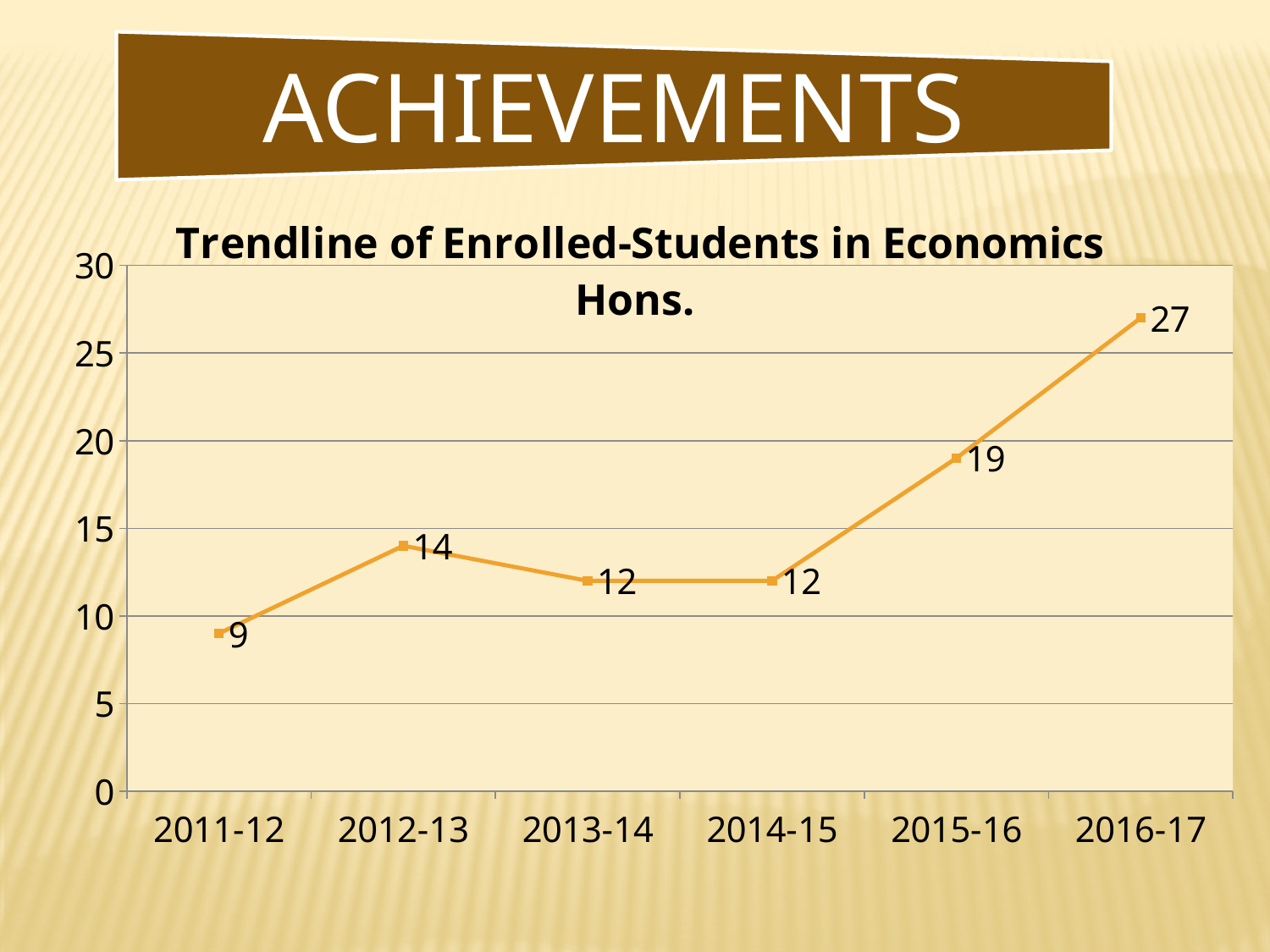
What is the value for 2011-12? 9 What kind of chart is this? line chart What is the difference between the values for 2016-17 and 2015-16? 8 Which year has the lowest value? 2011-12 Which is larger, the value for 2012-13 or the value for 2013-14? 2012-13 What is the value for 2015-16? 19 Do the values rise or fall from 2014-15 to 2016-17? rise Is the value for 2015-16 greater or less than 15? greater Which year has the highest value? 2016-17 What is the value for 2016-17? 27 How many years are plotted on the x axis? 6 What is the title of the chart? Trendline of Enrolled-Students in Economics Hons.